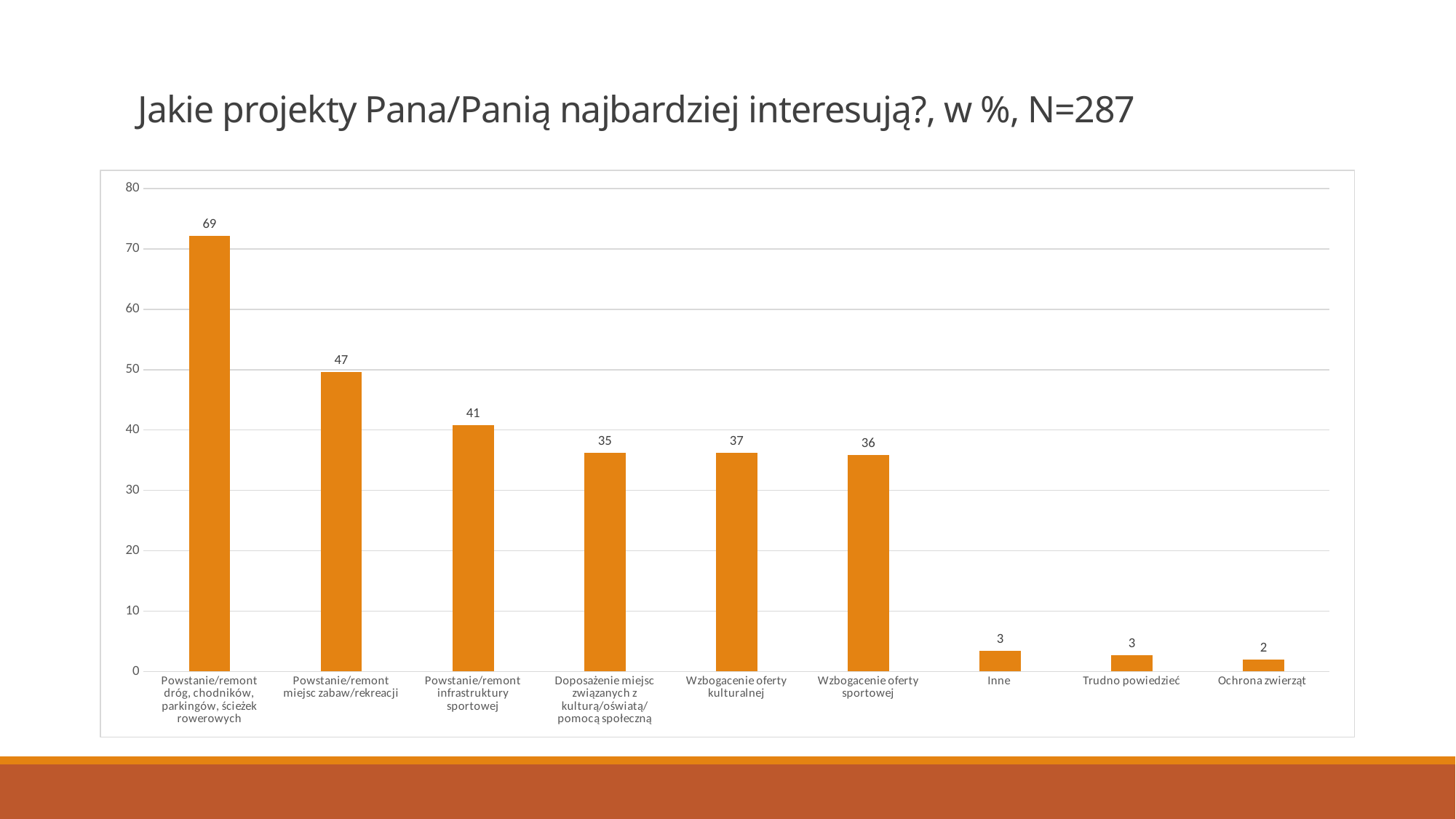
What is the value for "Powstanie/remont infrastruktury sportowej"? 41 Which is larger: the value for "Powstanie/remont miejsc zabaw/rekreacji" or the value for "Powstanie/remont infrastruktury sportowej"? Powstanie/remont miejsc zabaw/rekreacji What is the value for "Ochrona zwierząt"? 2 Which category has the lowest value? Ochrona zwierząt Is the value for "Wzbogacenie oferty sportowej" greater or less than 30? greater Which category has the highest value? Powstanie/remont dróg, chodników, parkingów, ścieżek rowerowych What is the difference between the values for "Powstanie/remont dróg, chodników, parkingów, ścieżek rowerowych" and "Powstanie/remont miejsc zabaw/rekreacji"? 22 What kind of chart is shown on the slide? bar chart What is the value for "Powstanie/remont dróg, chodników, parkingów, ścieżek rowerowych"? 69 How many categories are shown on the x axis? 9 What is the value for "Wzbogacenie oferty kulturalnej"? 37 What is the title of the slide? Jakie projekty Pana/Panią najbardziej interesują?, w %, N=287